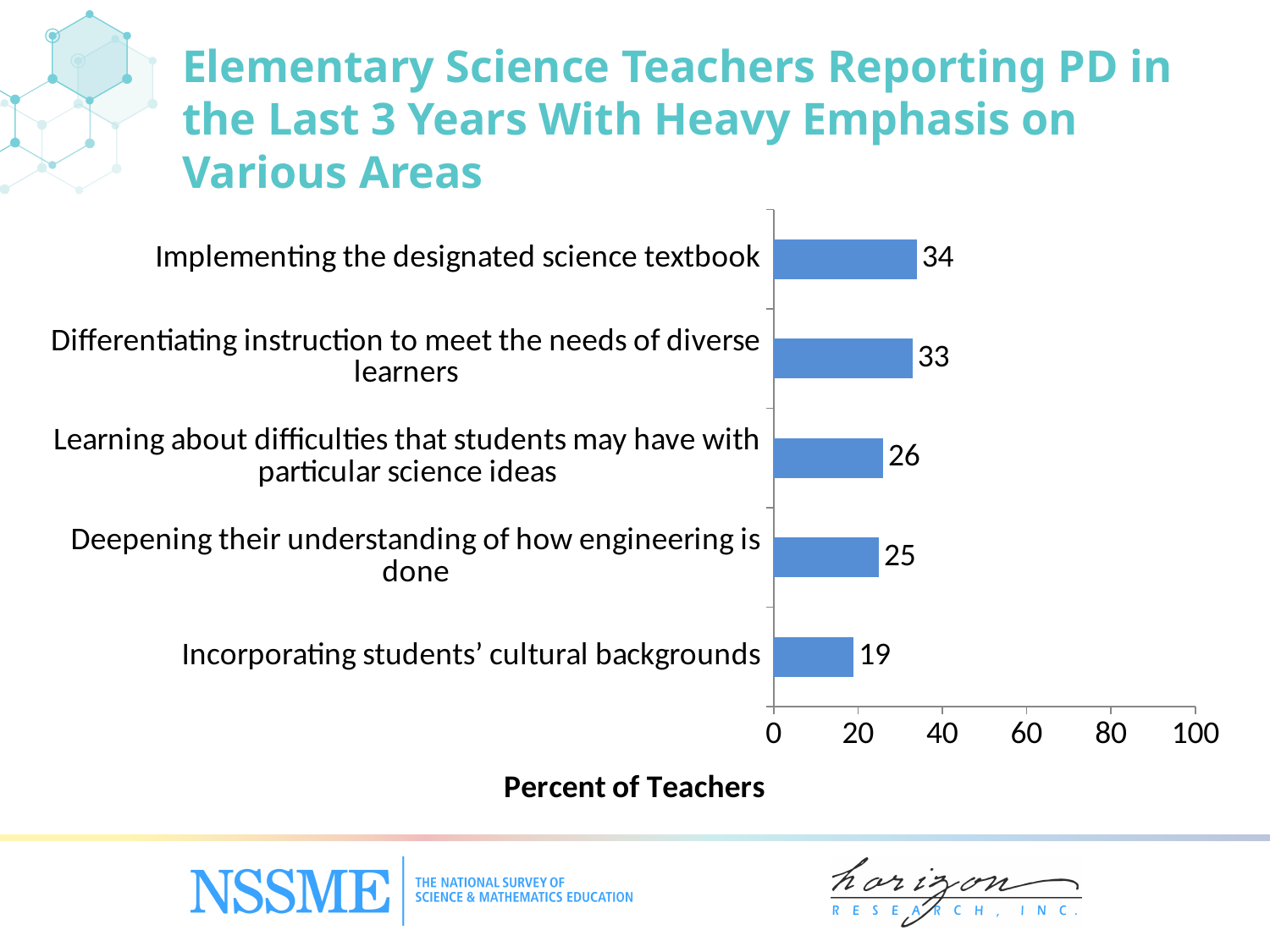
What percent of teachers reported PD with heavy emphasis on implementing the designated science textbook? 34 What is the difference between the values for differentiating instruction to meet the needs of diverse learners and learning about difficulties that students may have with particular science ideas? 7 How many areas are shown in the chart? 5 Which is larger: the value for learning about difficulties that students may have with particular science ideas or the value for incorporating students' cultural backgrounds? Learning about difficulties that students may have with particular science ideas What is the value for incorporating students' cultural backgrounds? 19 What is the label of the horizontal axis? Percent of Teachers Is the value for differentiating instruction to meet the needs of diverse learners greater or less than 40? less What is the value for deepening their understanding of how engineering is done? 25 Which area has the lowest percent of teachers? Incorporating students' cultural backgrounds What kind of chart is shown on the slide? Bar chart Which area has the highest percent of teachers? Implementing the designated science textbook What is the difference between the values for implementing the designated science textbook and incorporating students' cultural backgrounds? 15